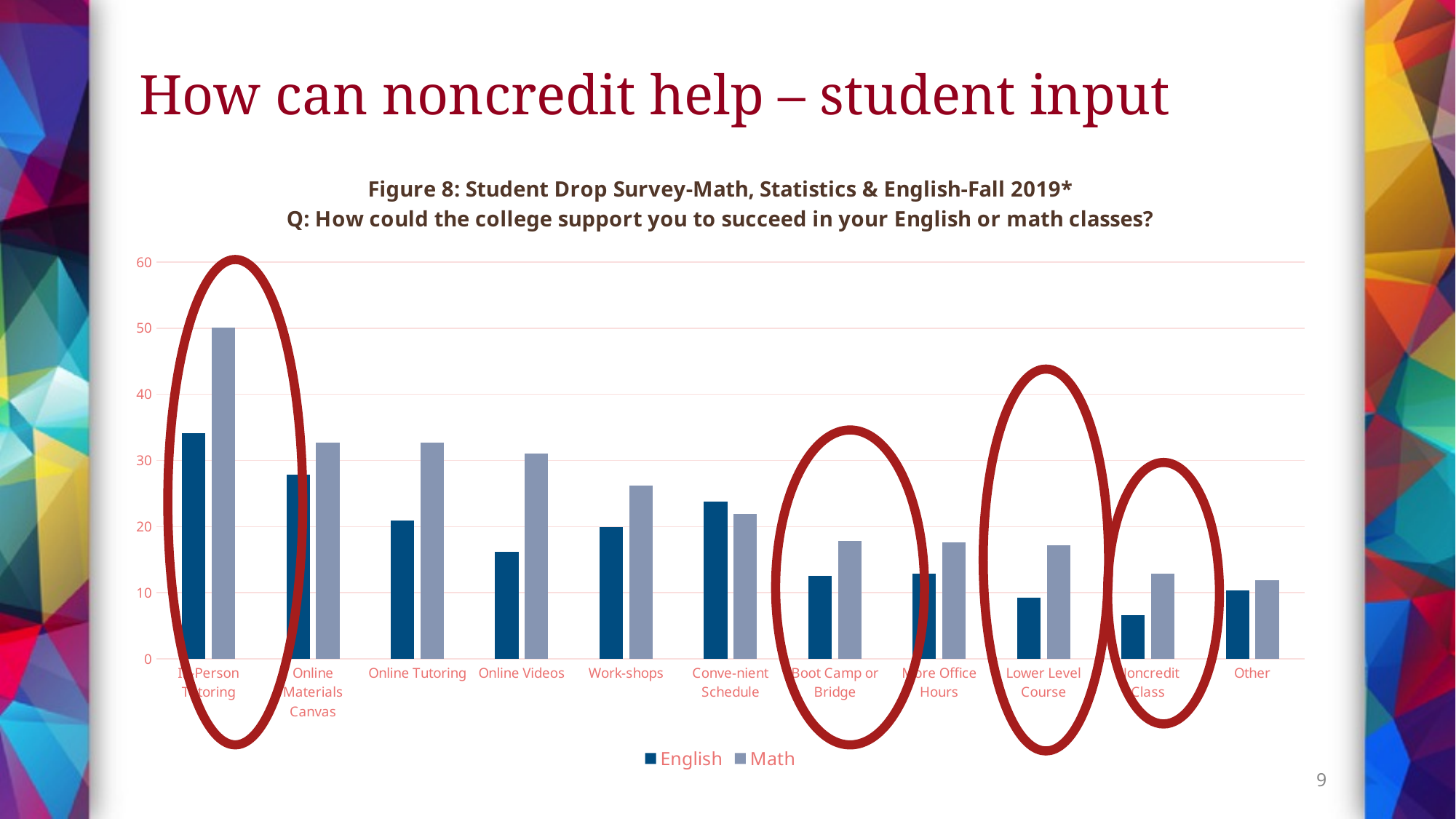
Do the Math values generally rise or fall moving from left to right along the x axis? fall Is the English value for Online Videos greater or less than 20? less Which category has the highest Math value? In-Person Tutoring Which category has the lowest English value? Noncredit Class For In-Person Tutoring, which series has the larger value, English or Math? Math How many series does the legend list? 2 Is the Math value for Boot Camp or Bridge greater or less than 20? less Is the English value for In-Person Tutoring greater or less than 30? greater How many categories are shown on the x axis? 11 What kind of chart is shown on the slide? bar chart What are the two series named in the legend? English and Math